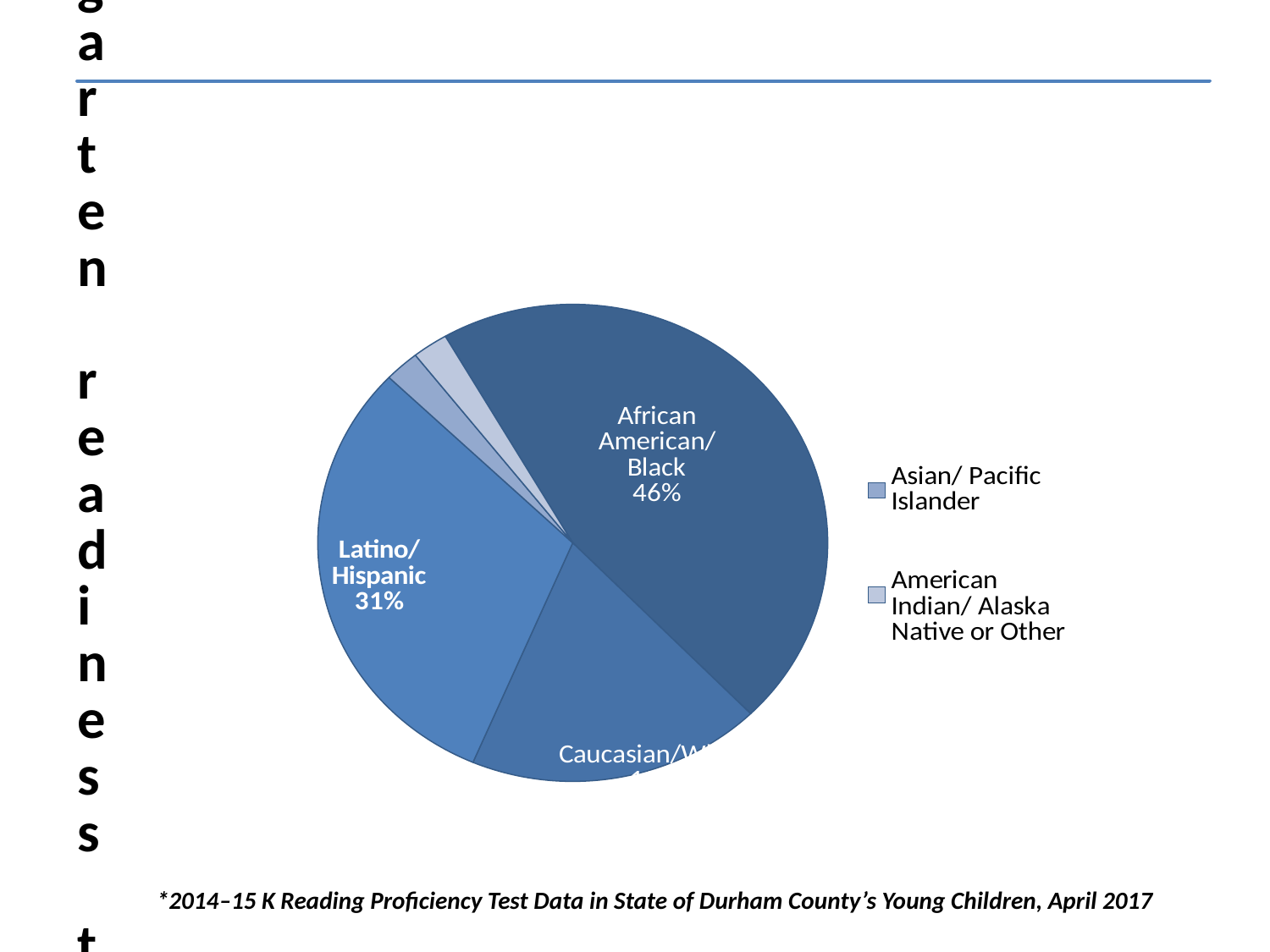
What kind of chart is shown on the slide? Pie chart Which slice is larger, African American/Black or Latino/Hispanic? African American/Black By how many percentage points does the African American/Black slice exceed the Latino/Hispanic slice? 15 percentage points Which slice is larger, Latino/Hispanic or Caucasian/White? Latino/Hispanic Which slice of the pie chart is the largest? African American/Black Which slice of the pie chart is labelled in bold white text? Latino/Hispanic What percentage of the pie chart is the African American/Black slice? 46% How many entries does the legend list? 2 What percentage of the pie chart is the Latino/Hispanic slice? 31% How many slices does the pie chart have? 5